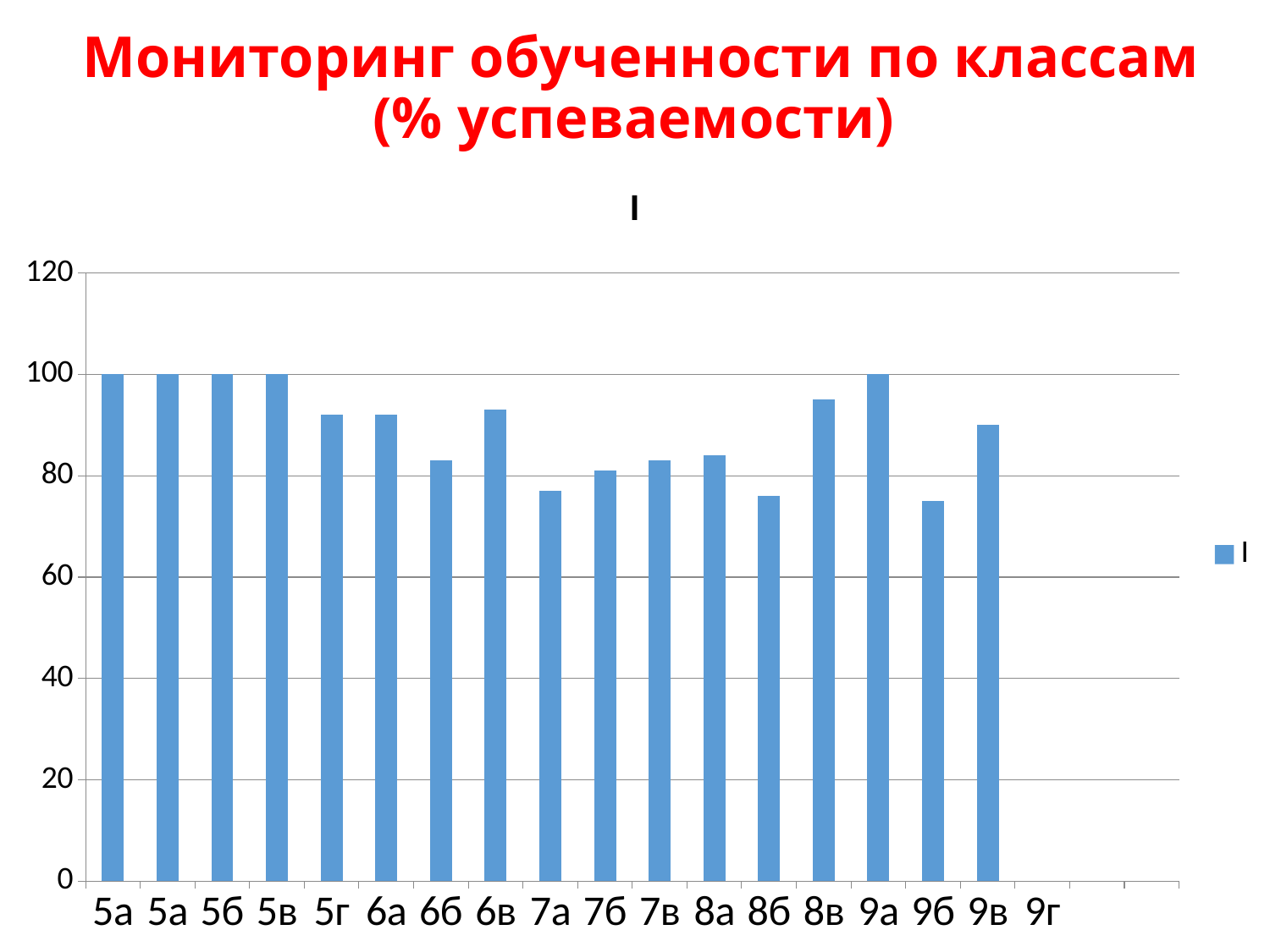
Is the value for 5г greater or less than 80? greater How many class categories are listed along the x axis? 18 What is the value for class 9а? 100 Which has the larger value, 5в or 6б? 5в How many series does the legend list? 1 What is the name of the series shown in the legend? I Which has the larger value, 8в or 9б? 8в Is the value for 9б greater or less than 80? less What kind of chart is shown on the slide? bar chart Is the value for 8б greater or less than 80? less What is the value for class 5б? 100